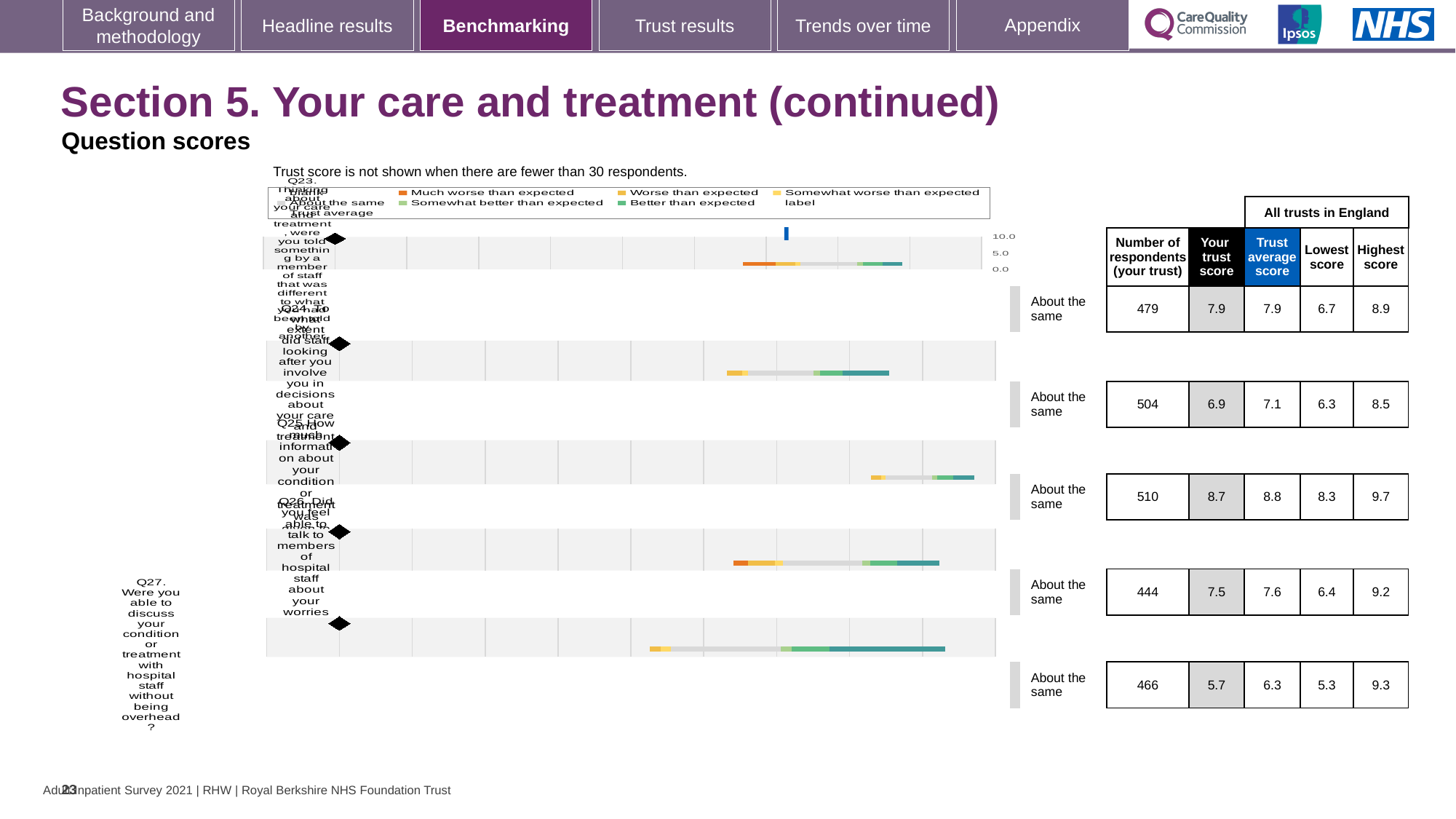
What is the lowest score across all trusts in England for Q24 (staff involving you in decisions)? 6.3 What is the 'Your trust score' for Q23 (being told something different by another member of staff)? 7.9 What kind of chart is used to show the benchmarking results? Bar chart How many questions are benchmarked on this slide? 5 How many respondents (your trust) are shown for Q25 (how much information about your condition or treatment)? 510 For Q27, what is the difference between the trust average score and your trust score? 0.6 Which question has the highest 'Your trust score' on this slide? Q25 For Q25, what is the difference between the highest score and the lowest score across all trusts in England? 1.4 Which question has the lowest 'Your trust score' on this slide? Q27 What benchmark category label is shown next to every question on this slide? About the same What is the highest score across all trusts in England for Q27 (discussing your condition without being overheard)? 9.3 Which has the higher 'Your trust score': Q23 or Q26? Q23